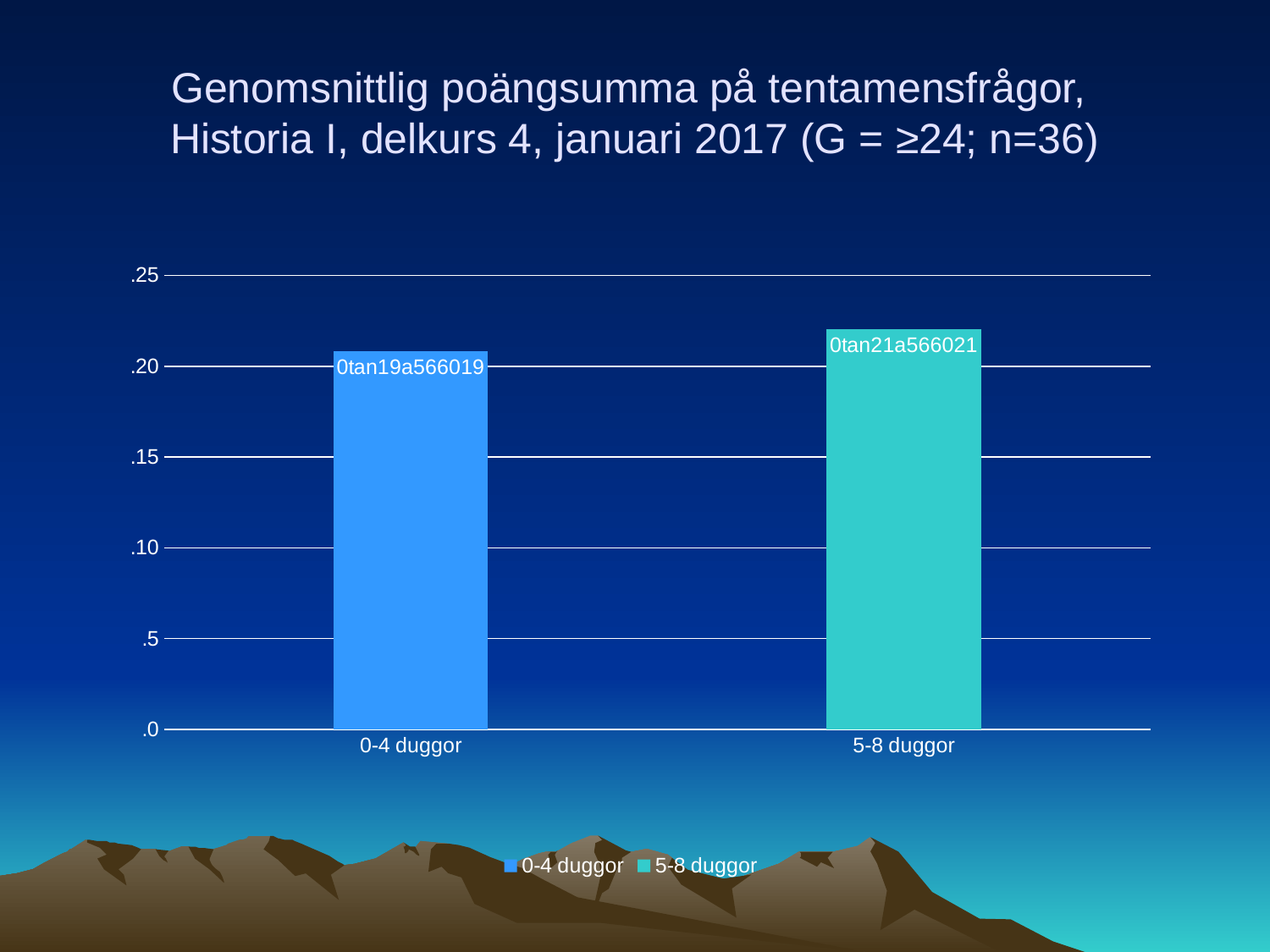
Is the value for 0-4 duggor greater or less than .15? greater Is the value for 5-8 duggor greater or less than .20? greater Which category has the highest bar in the chart? 5-8 duggor Is the value for 5-8 duggor greater or less than .25? less How many categories are shown on the x axis of the chart? 2 Which bar is taller, 0-4 duggor or 5-8 duggor? 5-8 duggor What are the two entries listed in the chart's legend? 0-4 duggor and 5-8 duggor What kind of chart is shown on the slide? bar chart Which category has the lowest bar in the chart? 0-4 duggor What is the title of the chart on the slide? Genomsnittlig poängsumma på tentamensfrågor, Historia I, delkurs 4, januari 2017 (G = ≥24; n=36) How many entries does the chart's legend list? 2